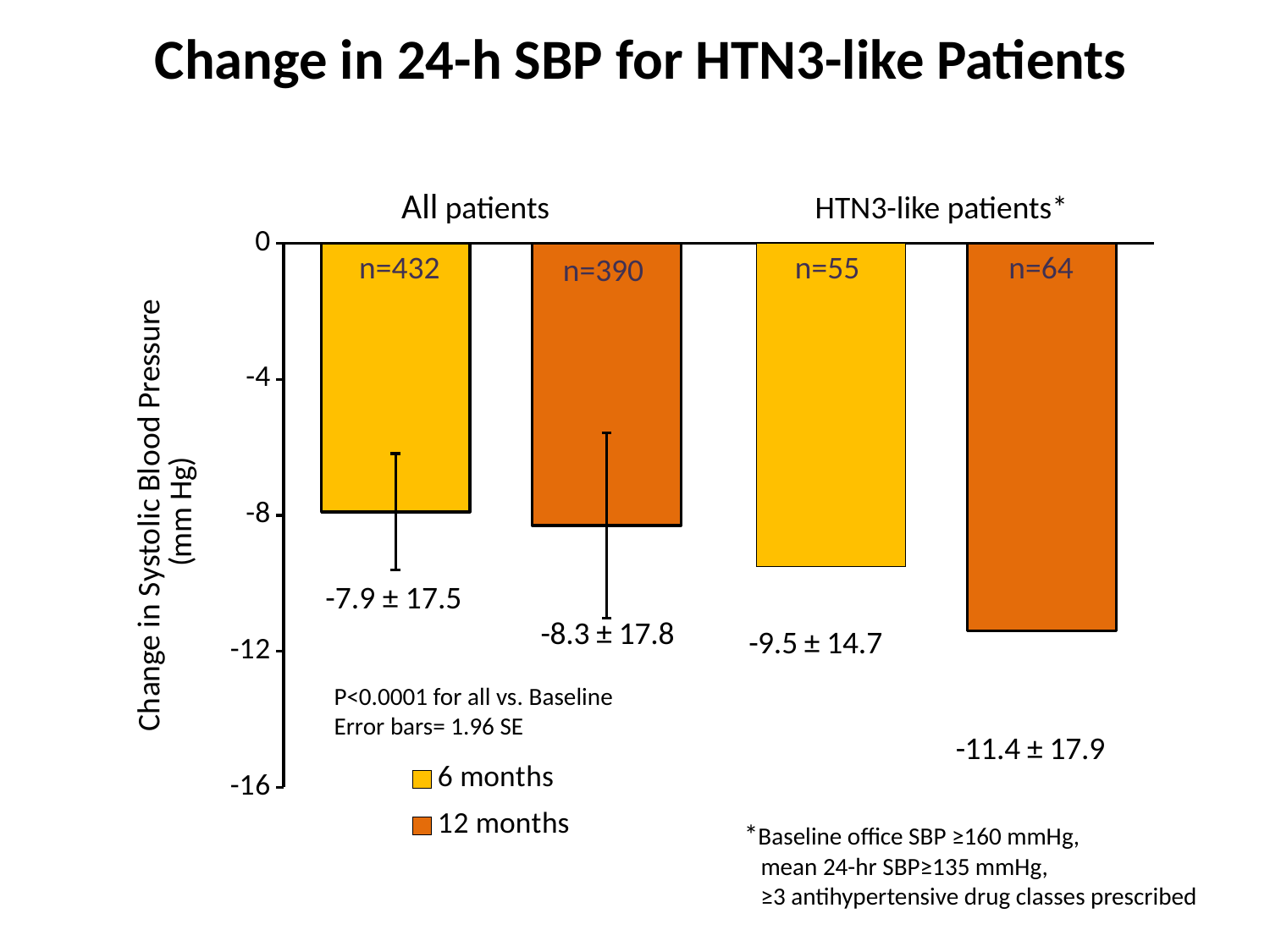
Which bar shows the smallest reduction in systolic blood pressure? All patients, 6 months What kind of chart is shown on the slide? Bar chart What does the legend say the error bars represent? 1.96 SE Which bar shows the largest reduction in systolic blood pressure? HTN3-like patients, 12 months How many patients (n) are in the 6-month bar for HTN3-like patients? n=55 What is the change in 24-h SBP at 12 months for HTN3-like patients? -11.4 ± 17.9 How many patients (n) are in the 12-month bar for all patients? n=390 How many series does the legend list? 2 What is the change in 24-h SBP at 6 months for all patients? -7.9 ± 17.5 How many bars are plotted on the chart? 4 Is the 12-month change for HTN3-like patients greater or less than -8 mm Hg (i.e., a larger reduction)? greater What is the change in 24-h SBP at 6 months for HTN3-like patients? -9.5 ± 14.7